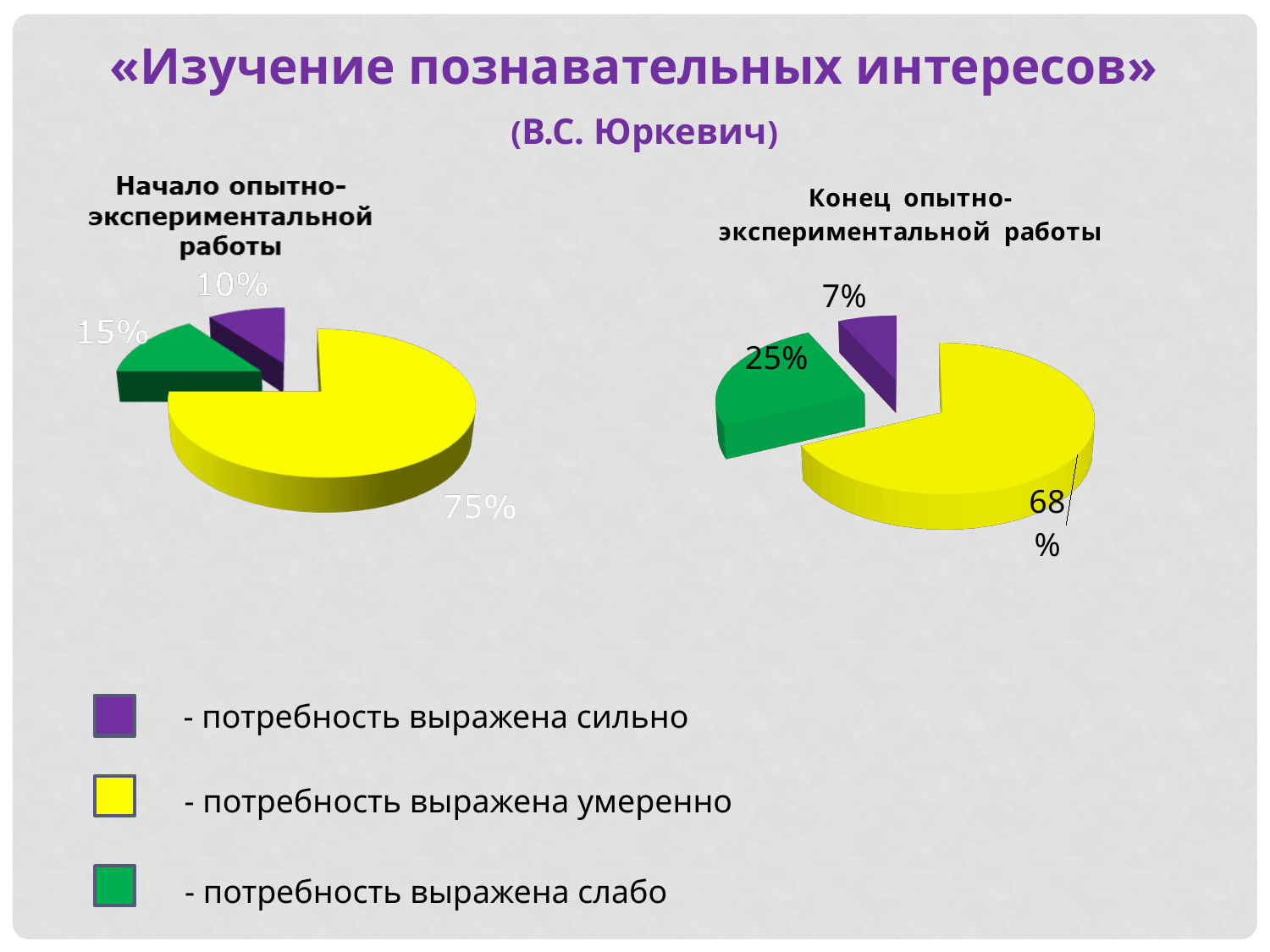
In the chart «Начало опытно-экспериментальной работы», what share is shown for «потребность выражена умеренно» (yellow)? 75% What kind of chart is used on the slide for «Начало опытно-экспериментальной работы»? pie chart In the chart «Начало опытно-экспериментальной работы», what share is shown for «потребность выражена слабо» (green)? 15% In the chart «Конец опытно-экспериментальной работы», what share is shown for «потребность выражена умеренно» (yellow)? 68% What is the difference between the «потребность выражена слабо» share in the «Конец» chart and in the «Начало» chart? 10% In the chart «Конец опытно-экспериментальной работы», what share is shown for «потребность выражена сильно» (purple)? 7% In the chart «Конец опытно-экспериментальной работы», which category has the largest slice? потребность выражена умеренно In the chart «Начало опытно-экспериментальной работы», which category has the smallest slice? потребность выражена сильно In the chart «Конец опытно-экспериментальной работы», what share is shown for «потребность выражена слабо» (green)? 25% In the chart «Начало опытно-экспериментальной работы», what share is shown for «потребность выражена сильно» (purple)? 10% How many slices does each pie chart on the slide have? 3 Which colour represents «потребность выражена слабо» in the legend? green